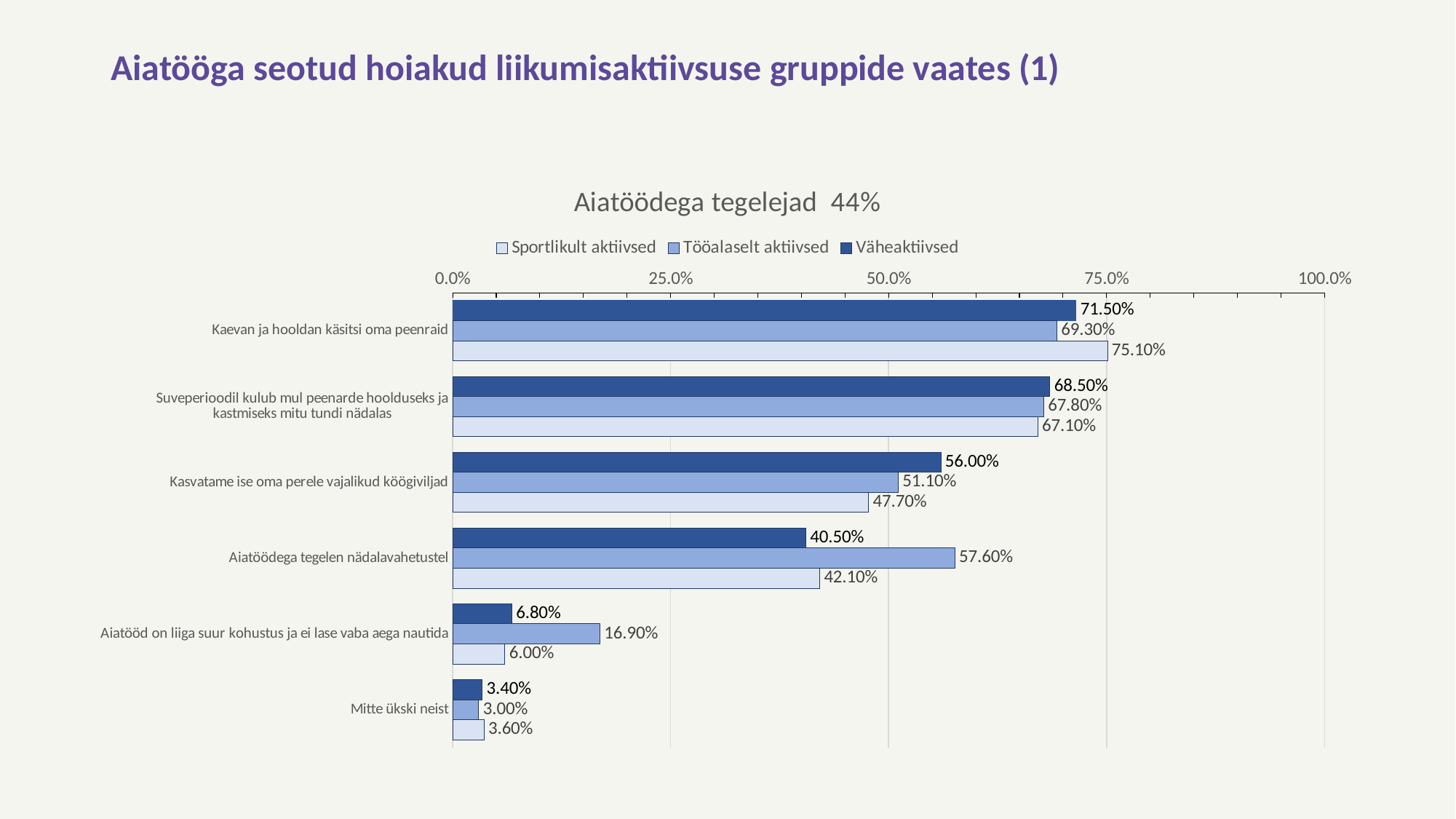
What is the value for Tööalaselt aktiivsed in the category 'Aiatöödega tegelen nädalavahetustel'? 57.60% Which category has the lowest value for Tööalaselt aktiivsed? Mitte ükski neist How many categories are shown on the chart? 6 What is the difference between the Tööalaselt aktiivsed and Väheaktiivsed values in the category 'Aiatöödega tegelen nädalavahetustel'? 17.10% In the category 'Aiatööd on liiga suur kohustus ja ei lase vaba aega nautida', which is larger: the value for Tööalaselt aktiivsed or for Sportlikult aktiivsed? Tööalaselt aktiivsed Is the value for Sportlikult aktiivsed in the category 'Kasvatame ise oma perele vajalikud köögiviljad' greater or less than 50.0%? less What is the title of the chart? Aiatöödega tegelejad 44% What type of chart is shown on the slide? bar chart What is the value for Sportlikult aktiivsed in the category 'Kaevan ja hooldan käsitsi oma peenraid'? 75.10% How many series does the legend list? 3 Which category has the highest value for Väheaktiivsed? Kaevan ja hooldan käsitsi oma peenraid What is the value for Väheaktiivsed in the category 'Kasvatame ise oma perele vajalikud köögiviljad'? 56.00%